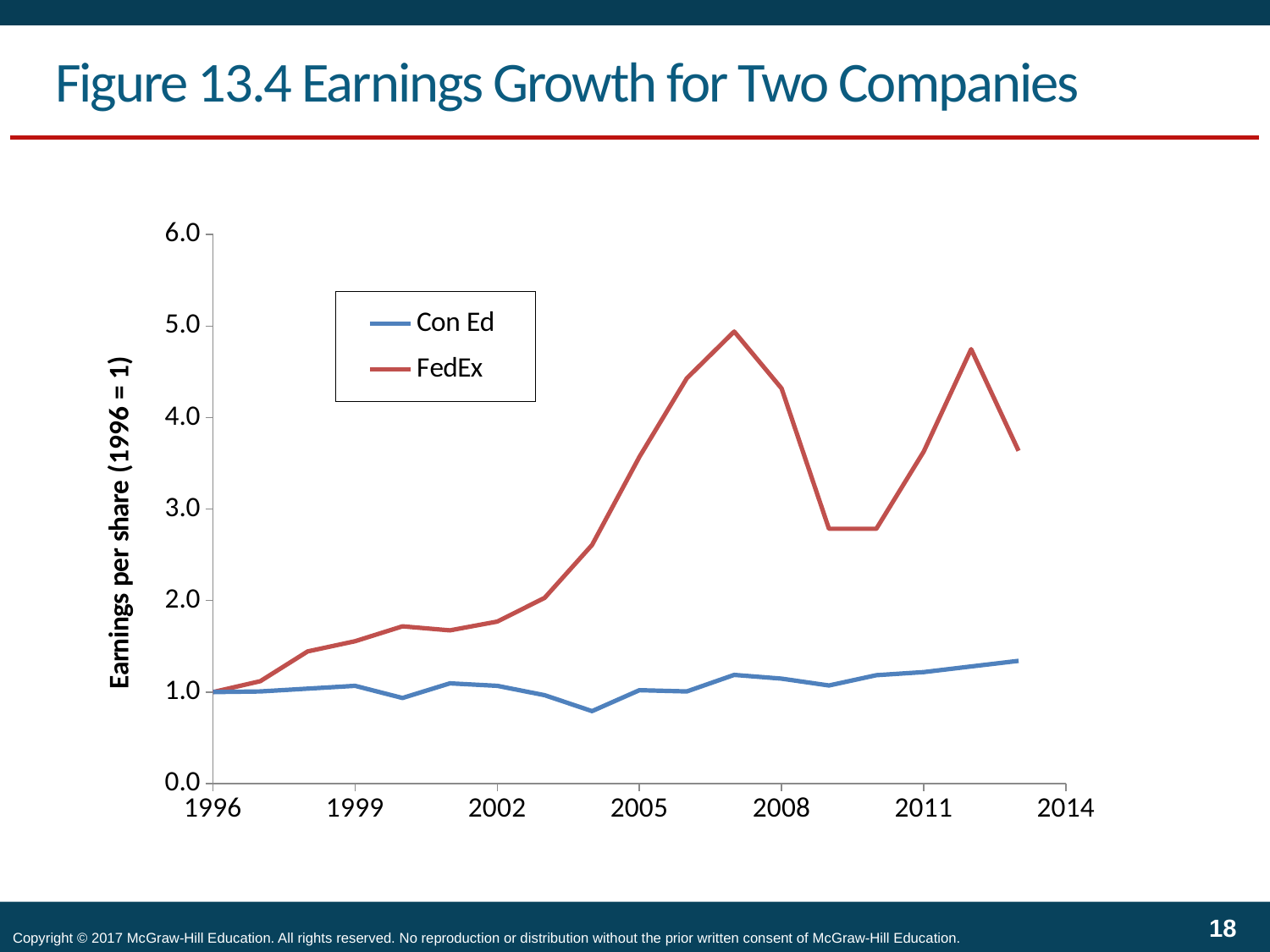
What is the label on the vertical axis? Earnings per share (1996 = 1) Is the value for FedEx in 2002 greater or less than 2.0? less What is the value for Con Ed in 1996? 1.0 Which company has the higher earnings per share in 2010, Con Ed or FedEx? FedEx What is the value for FedEx in 1996? 1.0 What kind of chart is shown on the slide? line chart Is the value for FedEx in 2007 greater or less than 4.0? greater How many series does the legend list? 2 Overall, does the FedEx line rise or fall from 1996 to 2013? rise Is the value for Con Ed in 2004 greater or less than 1.0? less Which two companies are shown in the legend? Con Ed and FedEx